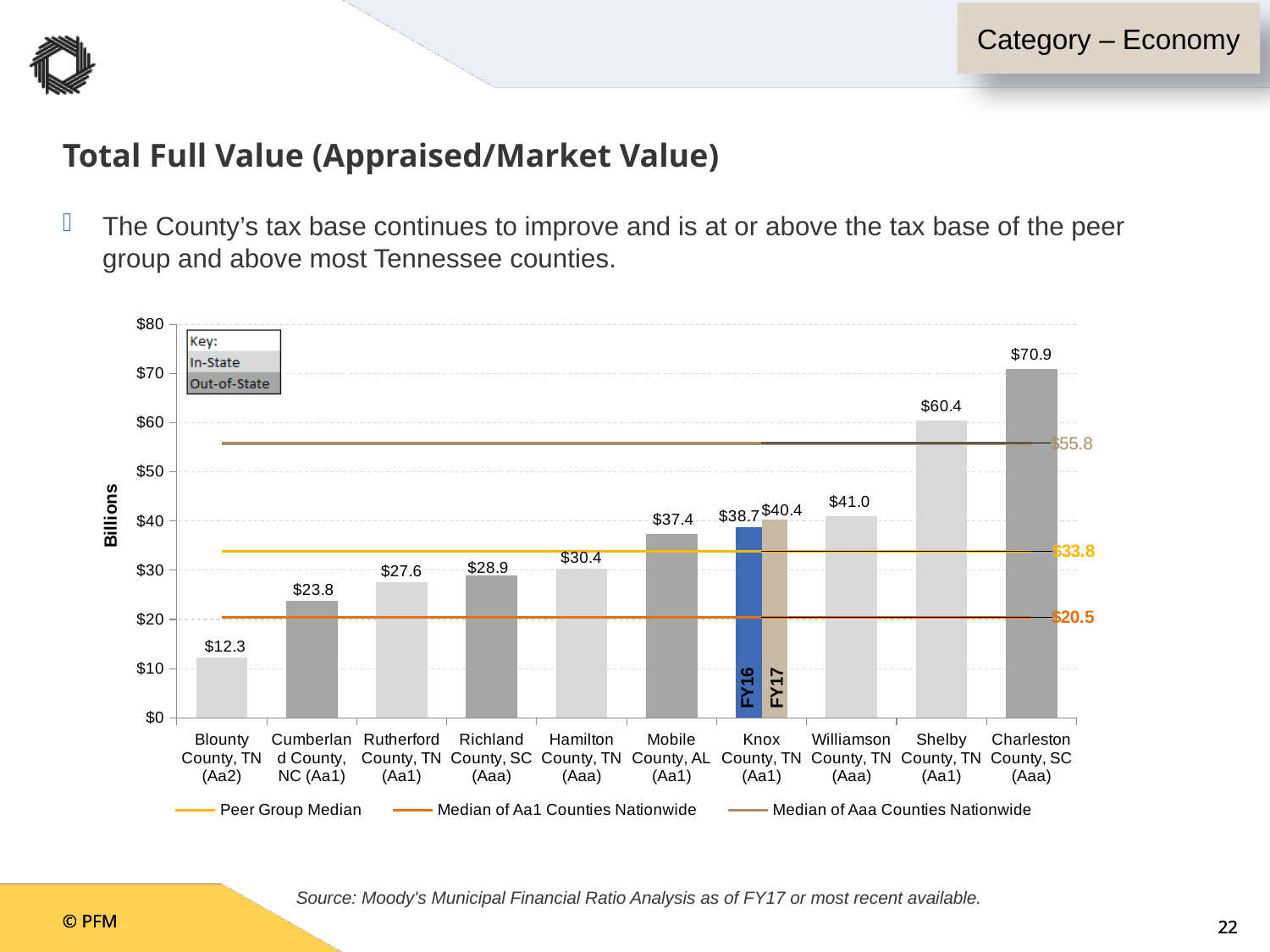
What is the value of the Peer Group Median line? $33.8 What is the value of the Median of Aaa Counties Nationwide line? $55.8 Which county has the highest Total Full Value? Charleston County, SC (Aaa) Which county has the lowest Total Full Value? Blount County, TN (Aa2) How many counties are shown on the x axis of the chart? 10 What is the FY17 Total Full Value for Knox County, TN (Aa1)? $40.4 What is the Total Full Value for Charleston County, SC (Aaa)? $70.9 What is the FY16 Total Full Value for Knox County, TN (Aa1)? $38.7 What is the difference between the Total Full Value of Shelby County, TN and Williamson County, TN? $19.4 Which is larger, the Total Full Value of Mobile County, AL or Hamilton County, TN? Mobile County, AL What is the Total Full Value for Blount County, TN (Aa2)? $12.3 How many median lines does the legend below the chart list? 3